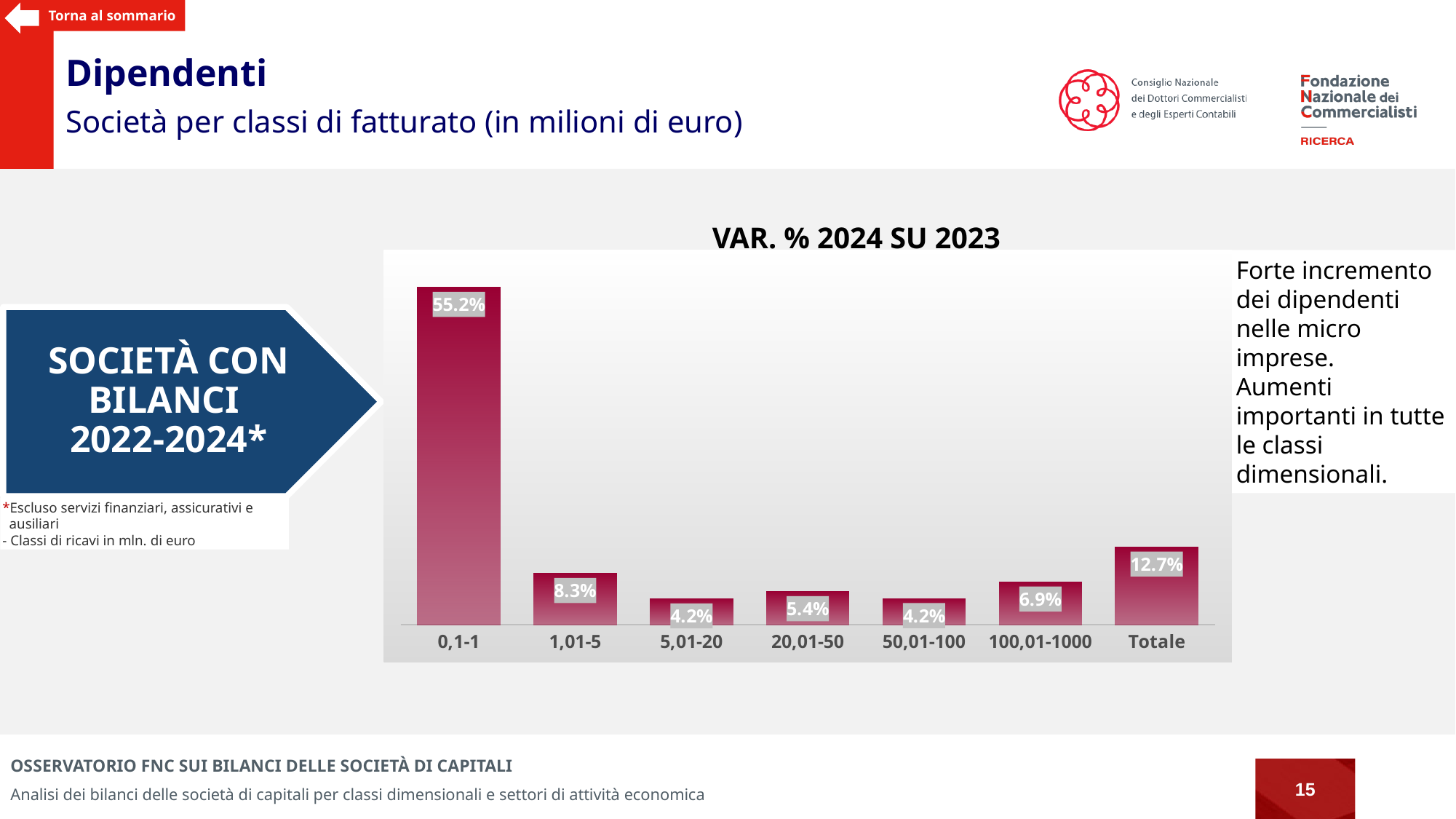
What kind of chart is shown? bar chart How many categories are shown on the x axis? 7 What is the value for the Totale category? 12.7% What is the difference between the values for 0,1-1 and 1,01-5? 46.9% What is the value for the 0,1-1 category? 55.2% What is the value for the 20,01-50 category? 5.4% What is the difference between the values for Totale and 100,01-1000? 5.8% Which category has the highest value? 0,1-1 Which two categories share the same value of 4.2%? 5,01-20 and 50,01-100 What is the title of the chart? VAR. % 2024 SU 2023 Which is larger, the value for 1,01-5 or the value for 100,01-1000? 1,01-5 What is the value for the 100,01-1000 category? 6.9%